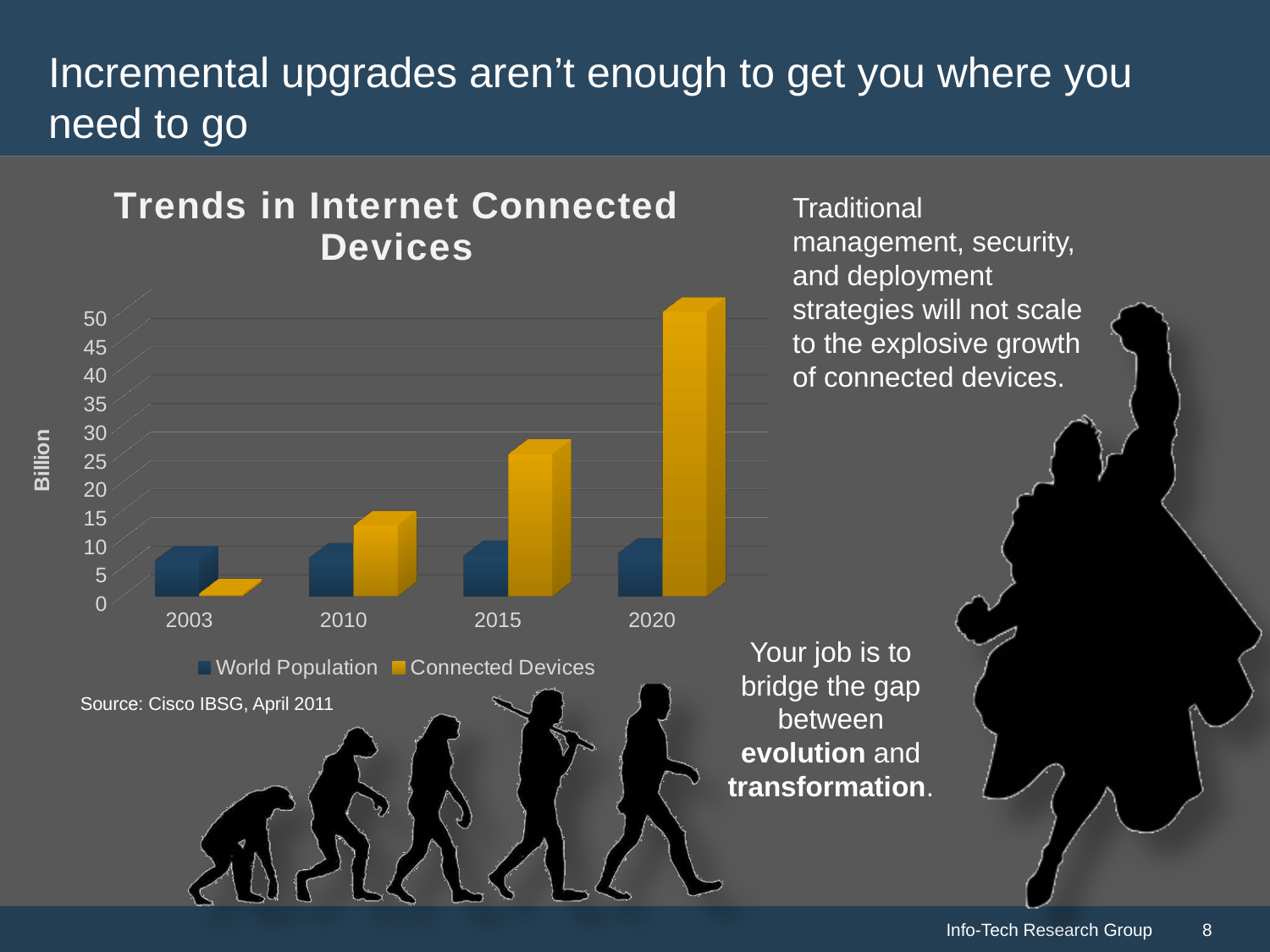
Is the Connected Devices value for 2015 greater or less than 20? greater In 2020, which is larger: World Population or Connected Devices? Connected Devices Do the Connected Devices values rise or fall from 2003 to 2020? rise What kind of chart is shown on the slide? bar chart How many series does the chart's legend list? 2 In which year is the Connected Devices value highest? 2020 In which year is the Connected Devices value lowest? 2003 How many years are shown on the x axis of the chart? 4 In 2003, which is larger: World Population or Connected Devices? World Population Is the Connected Devices value for 2003 greater or less than 5? less Is the World Population value for 2010 greater or less than 10? less What is the label on the chart's vertical axis? Billion